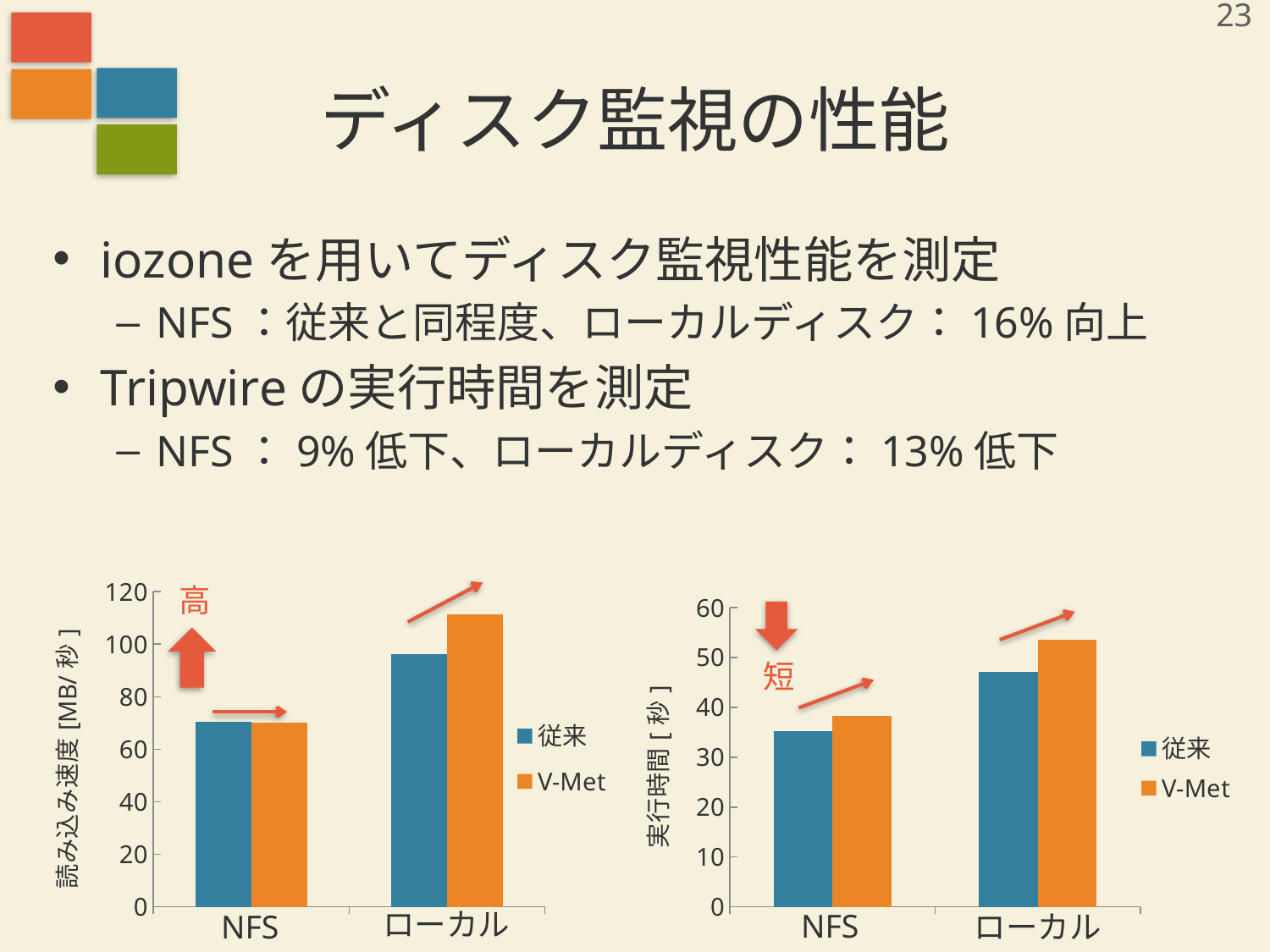
In the right chart (実行時間), is the 従来 value for NFS greater or less than 40? less How many series does the legend of the right chart (実行時間) list? 2 In the left chart (読み込み速度), is the V-Met value for ローカル greater or less than 100? greater In the right chart (実行時間), is the 従来 value for ローカル greater or less than 50? less How many categories are shown on the x axis of the left chart (読み込み速度)? 2 What type of chart is the left chart (読み込み速度)? bar chart In the left chart (読み込み速度), which series has the larger value for ローカル, 従来 or V-Met? V-Met What is the y-axis label of the right chart? 実行時間 [秒] In the right chart (実行時間), which category and series has the lowest bar? NFS, 従来 In the left chart (読み込み速度), which category and series has the highest bar? ローカル, V-Met